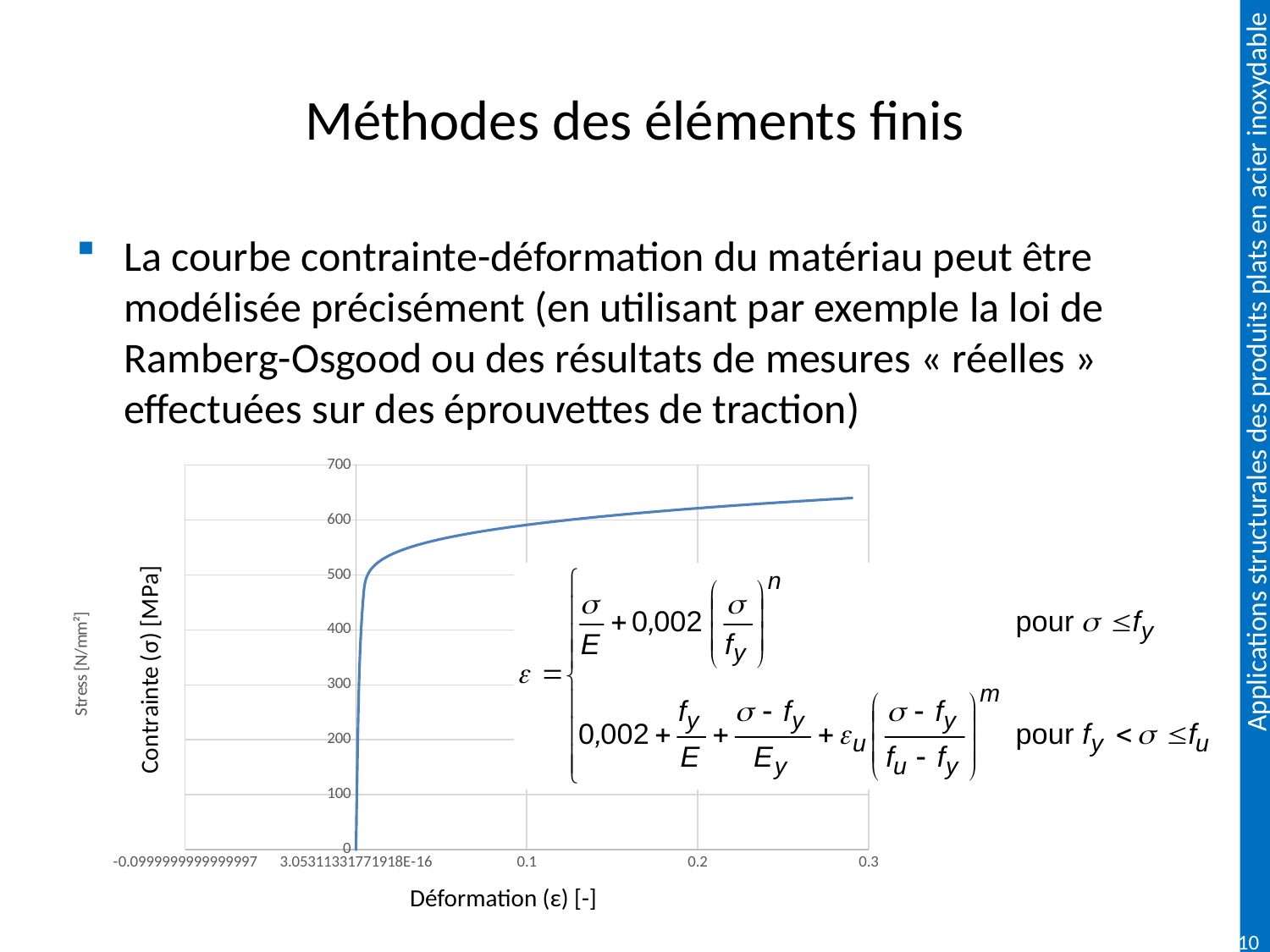
Is the stress value at a strain of 0.2 greater or less than 500? greater Does the stress value rise or fall as the strain increases along the x axis? rise What is the title of the horizontal axis of the chart? Déformation (ε) [-] Is the stress value at the right end of the curve (near a strain of 0.3) greater or less than 700? less Is the stress value at a strain of 0.1 greater or less than 500? greater What is the highest value shown on the vertical axis of the chart? 700 How many data series are plotted on the chart? 1 What is the title of the vertical axis of the chart? Contrainte (σ) [MPa] What kind of chart is shown on the slide? line chart